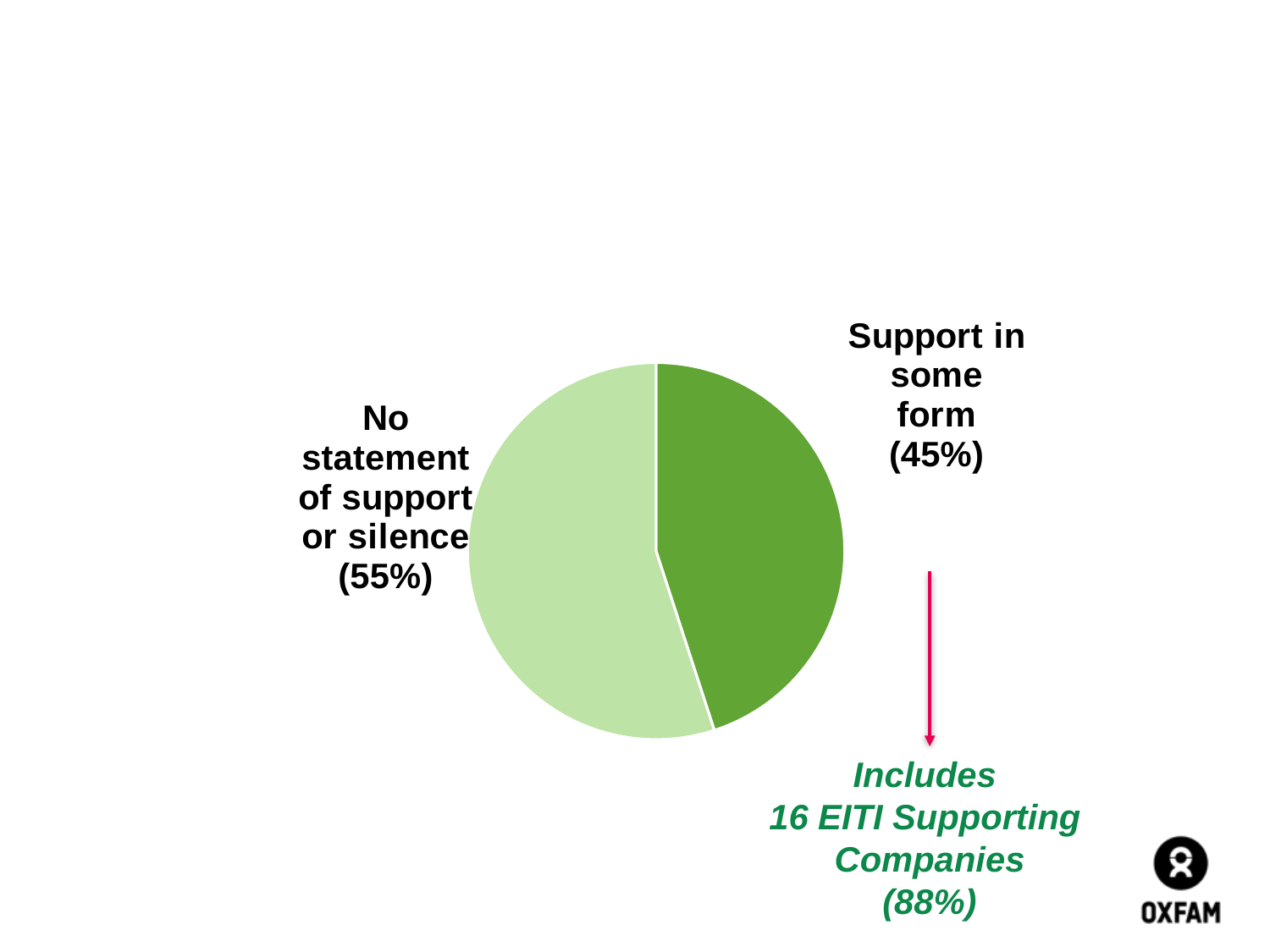
Which is larger: the "Support in some form" slice or the "No statement of support or silence" slice? No statement of support or silence Which slice of the pie is the largest? No statement of support or silence According to the annotation, how many EITI Supporting Companies are included in the "Support in some form" slice? 16 Which slice of the pie is the smallest? Support in some form What share of the pie is labelled "Support in some form"? 45% What colour is the "Support in some form" slice? dark green What is the difference in percentage points between the "No statement of support or silence" slice and the "Support in some form" slice? 10 percentage points What kind of chart is shown on the slide? pie chart How many slices does the pie chart have? 2 What share of the pie is labelled "No statement of support or silence"? 55% Is the share for "Support in some form" greater or less than 50%? less